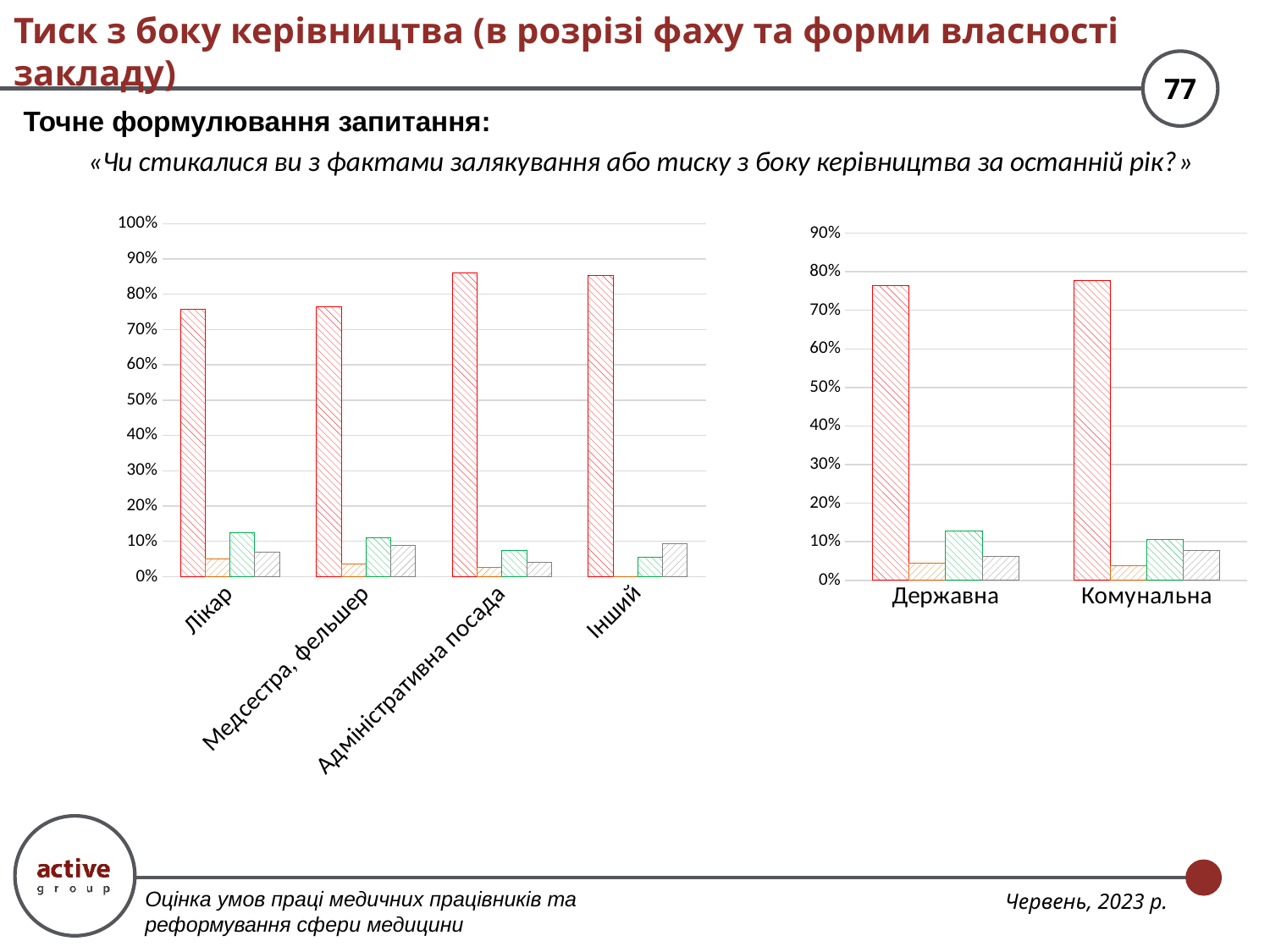
In the left chart, for Адміністративна посада, which is larger: the green hatched bar or the grey hatched bar? the green hatched bar In the left chart, for Лікар, which is larger: the green hatched bar or the grey hatched bar? the green hatched bar How many categories are shown on the x axis of the right chart? 2 How many categories are shown on the x axis of the left chart? 4 In the right chart, is the value of the tallest (red hatched) bar for Державна greater or less than 70%? greater In the left chart, is the value of the tallest (red hatched) bar for Лікар greater or less than 70%? greater In the left chart, is the value of the tallest (red hatched) bar for Лікар greater or less than 80%? less What is the highest value shown on the y axis of the right chart? 90% What kind of chart is the left chart on the slide? bar chart